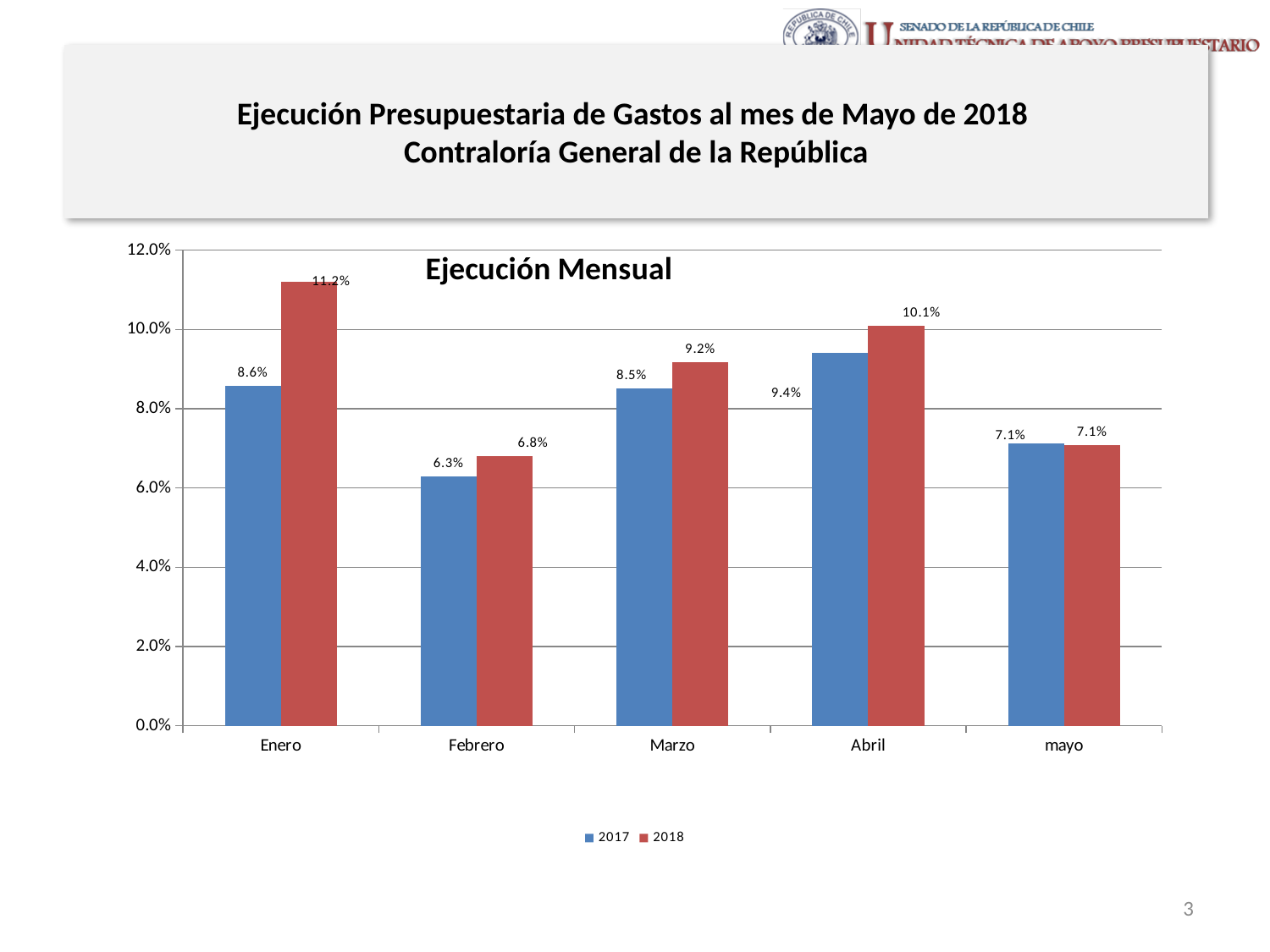
What is the value for 2018 in Abril? 10.1% What is the difference between the 2018 and 2017 values in Enero? 2.6% Is the value for 2017 in Abril greater or less than 8.0%? greater Which month has the highest value for the 2018 series? Enero What type of chart is shown on the slide? bar chart How many series does the legend list? 2 Which month has the lowest value for the 2017 series? Febrero What is the title of the chart? Ejecución Mensual How many months are shown on the x axis? 5 What is the value for 2017 in Febrero? 6.3% What is the value for 2018 in Enero? 11.2% Which is larger in Marzo, the 2017 value or the 2018 value? 2018